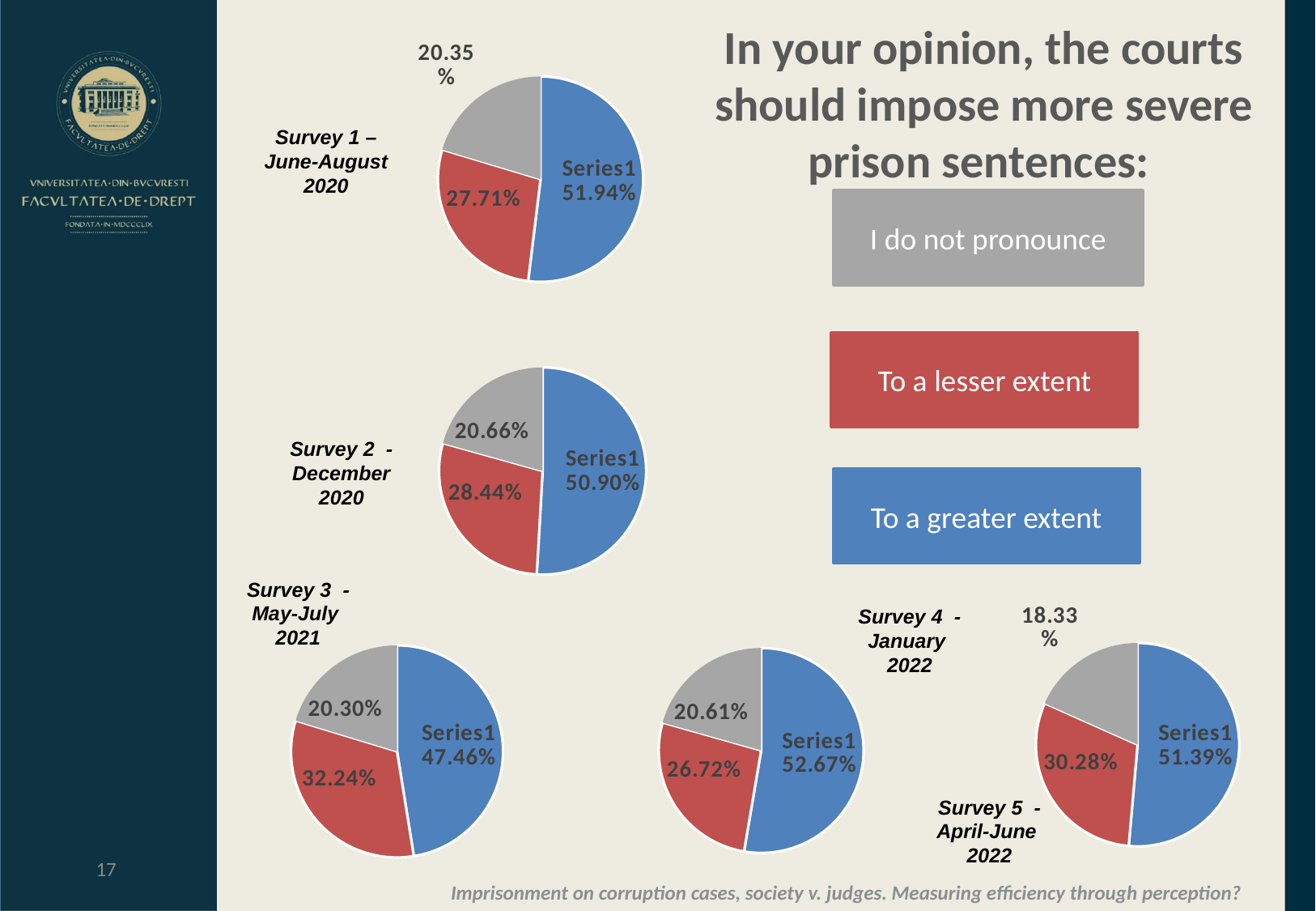
In the Survey 1 – June-August 2020 pie chart, what percentage is shown for the blue slice (To a greater extent)? 51.94% In the Survey 3 - May-July 2021 pie chart, which slice is the largest? To a greater extent (47.46%) In the Survey 5 - April-June 2022 pie chart, what percentage is shown for the red slice (To a lesser extent)? 30.28% What type of chart is used for Survey 2 - December 2020? Pie chart In the Survey 4 - January 2022 pie chart, what percentage is shown for the blue slice (To a greater extent)? 52.67% How many pie charts are shown on the slide? 5 In the Survey 2 - December 2020 pie chart, what percentage is shown for the red slice (To a lesser extent)? 28.44% According to the legend on the slide, which response does the red colour represent? To a lesser extent In the Survey 1 – June-August 2020 pie chart, what is the difference between the blue slice (51.94%) and the red slice (27.71%)? 24.23% In the Survey 3 - May-July 2021 pie chart, what percentage is shown for the grey slice (I do not pronounce)? 20.30% Is the blue slice (To a greater extent) larger in the Survey 4 - January 2022 pie chart or in the Survey 3 - May-July 2021 pie chart? Survey 4 - January 2022 In the Survey 5 - April-June 2022 pie chart, which slice is the smallest? I do not pronounce (18.33%)